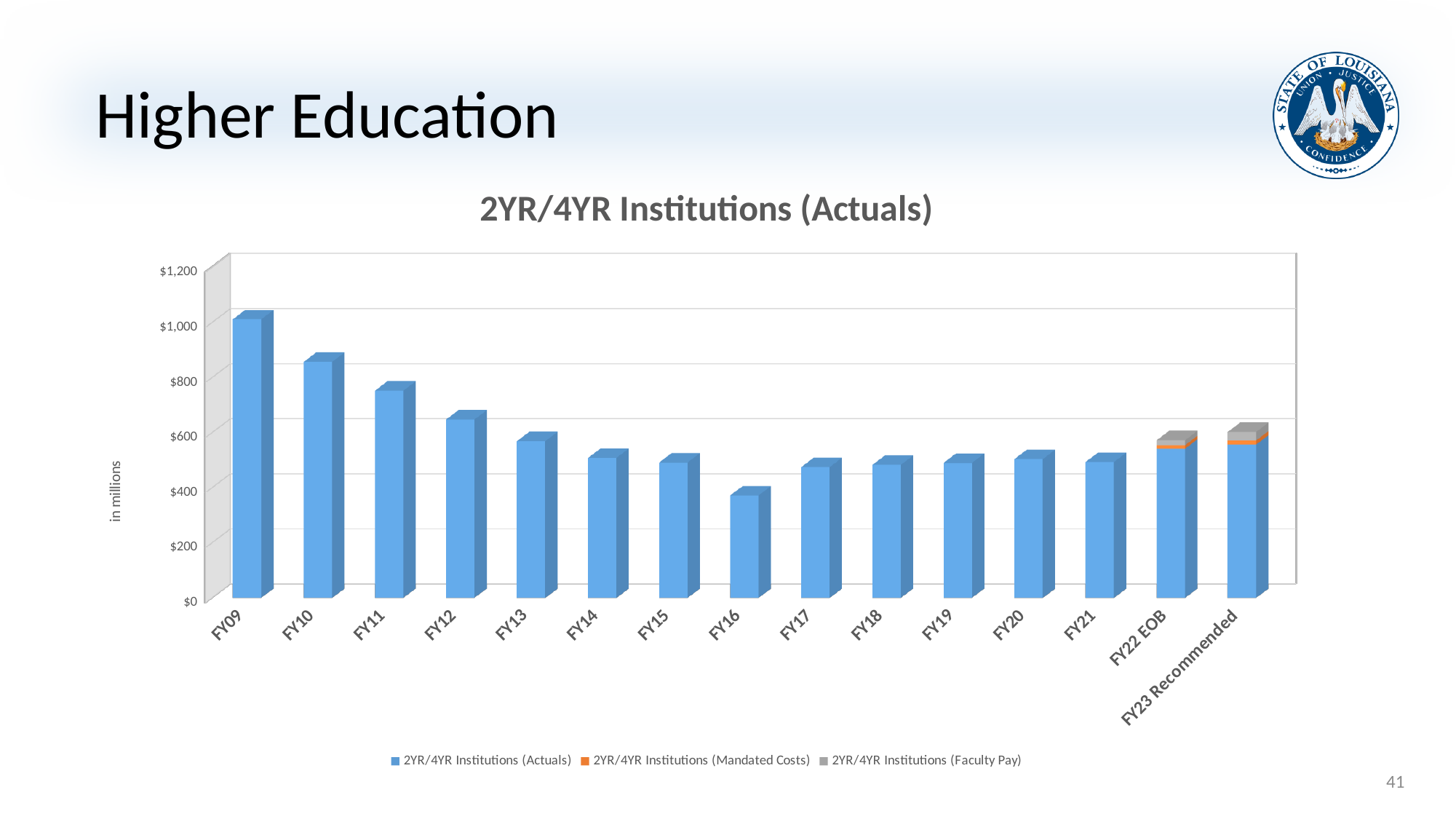
Which fiscal year has the highest bar in the chart? FY09 How many categories are shown along the x axis of the chart? 15 Is the value for FY11 greater or less than $800? less Do the values rise or fall from FY09 to FY16? fall What kind of chart is shown on the slide? bar chart How many series does the chart's legend list? 3 Which fiscal year has the lowest bar in the chart? FY16 Is the value for FY09 greater or less than $800? greater Is the value for FY12 greater or less than $600? greater Which is larger, the value for FY09 or the value for FY10? FY09 What unit does the y-axis label say the values are in? in millions